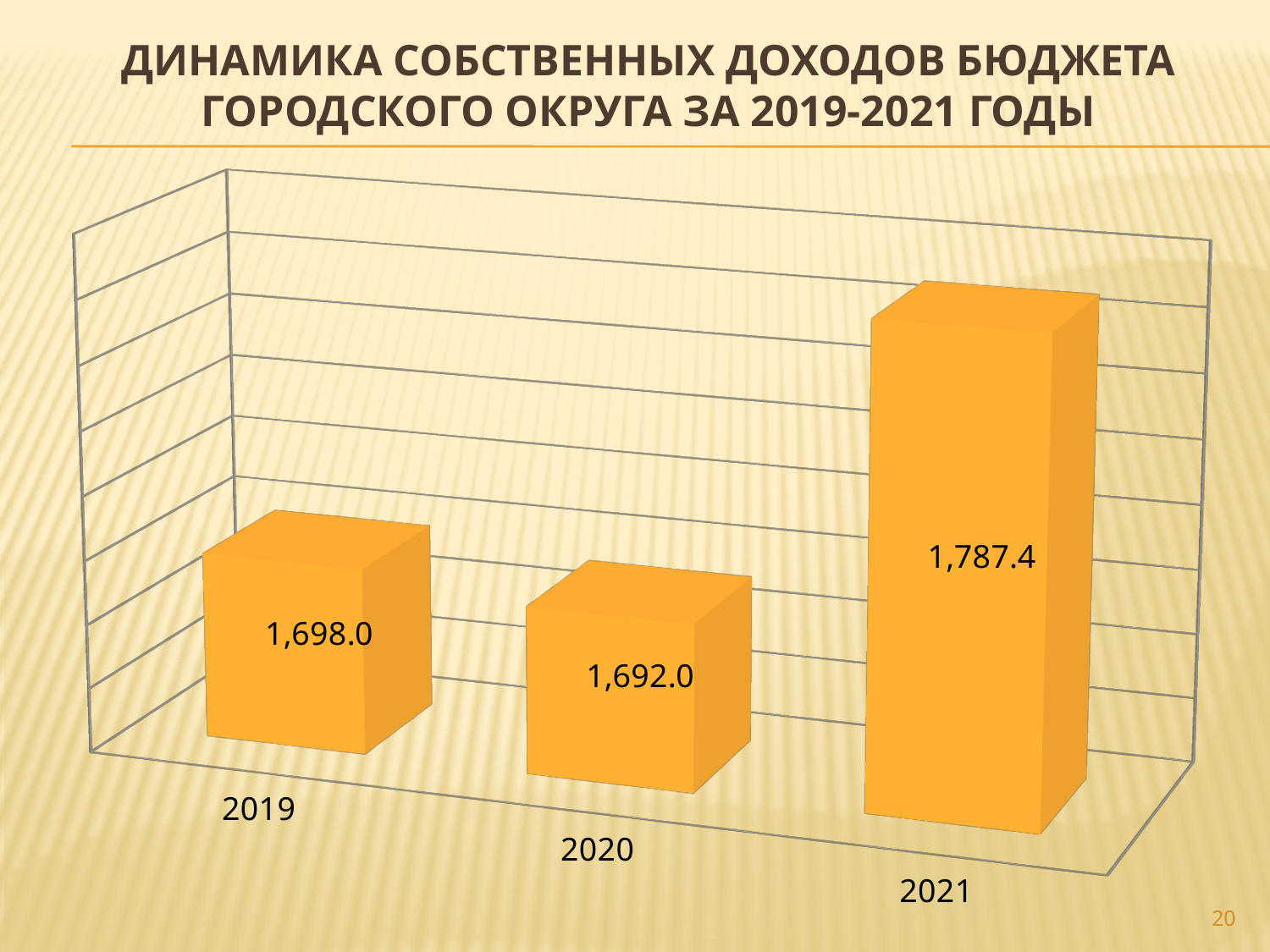
What is the value shown for 2020? 1,692.0 What is the difference between the values for 2019 and 2020? 6.0 What is the value shown for 2019? 1,698.0 Which year has the highest value? 2021 What is the difference between the values for 2021 and 2019? 89.4 Do the values rise or fall from 2020 to 2021? Rise What is the difference between the values for 2021 and 2020? 95.4 Which is larger, the value for 2019 or the value for 2020? 2019 What kind of chart is shown on the slide? Bar chart What is the value shown for 2021? 1,787.4 How many years are shown on the chart? 3 Which year has the lowest value? 2020